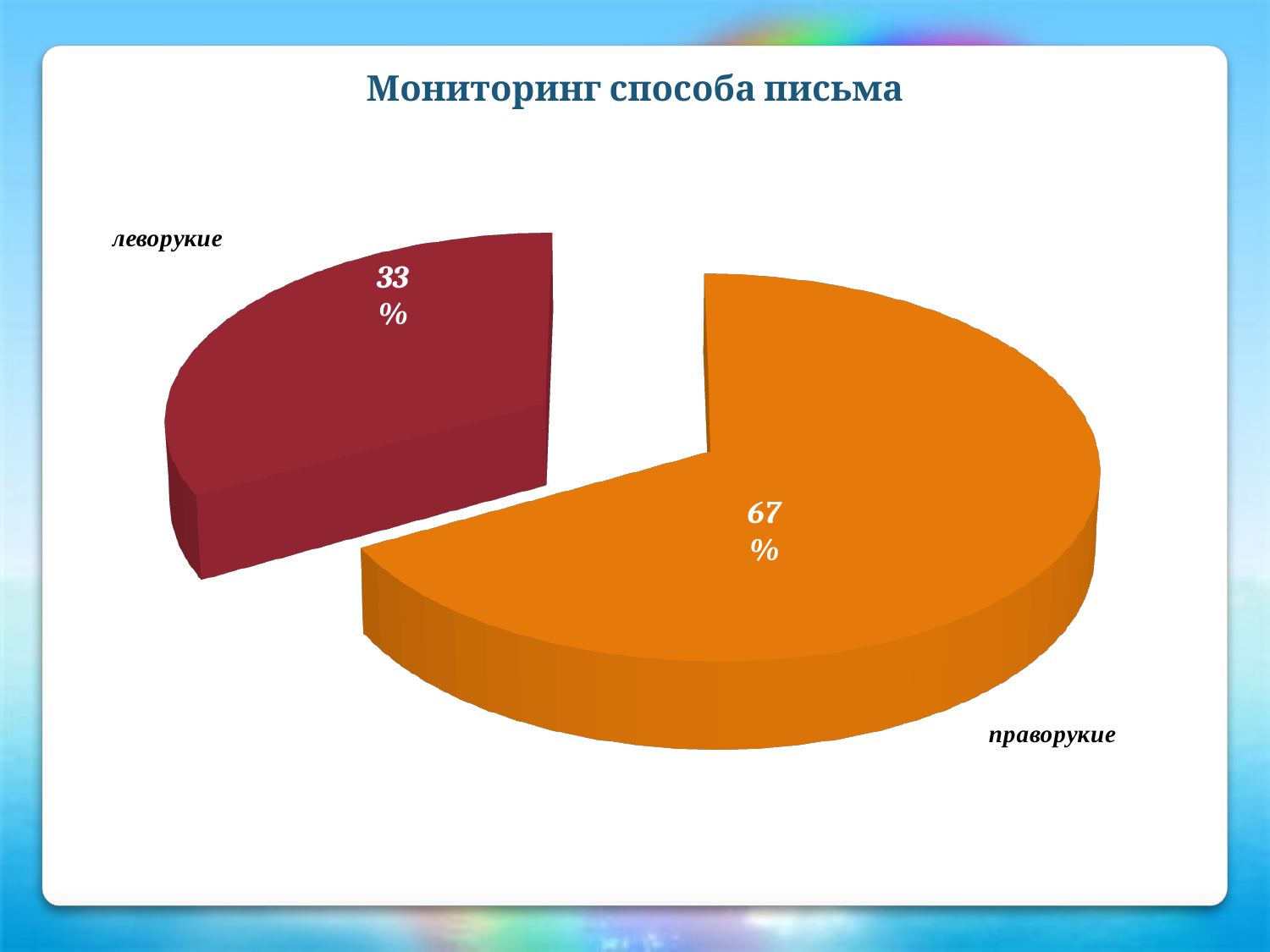
What share of the pie does the 'леворукие' slice represent? 33% Which slice is larger, 'леворукие' or 'праворукие'? праворукие What kind of chart is shown on the slide? pie chart What colour is the 'праворукие' slice? orange How many slices does the pie chart have? 2 Which category has the largest slice of the pie? праворукие What is the difference in percentage points between the 'праворукие' and 'леворукие' slices? 34 Which category has the smallest slice of the pie? леворукие What share of the pie does the 'праворукие' slice represent? 67% What is the title of the chart? Мониторинг способа письма